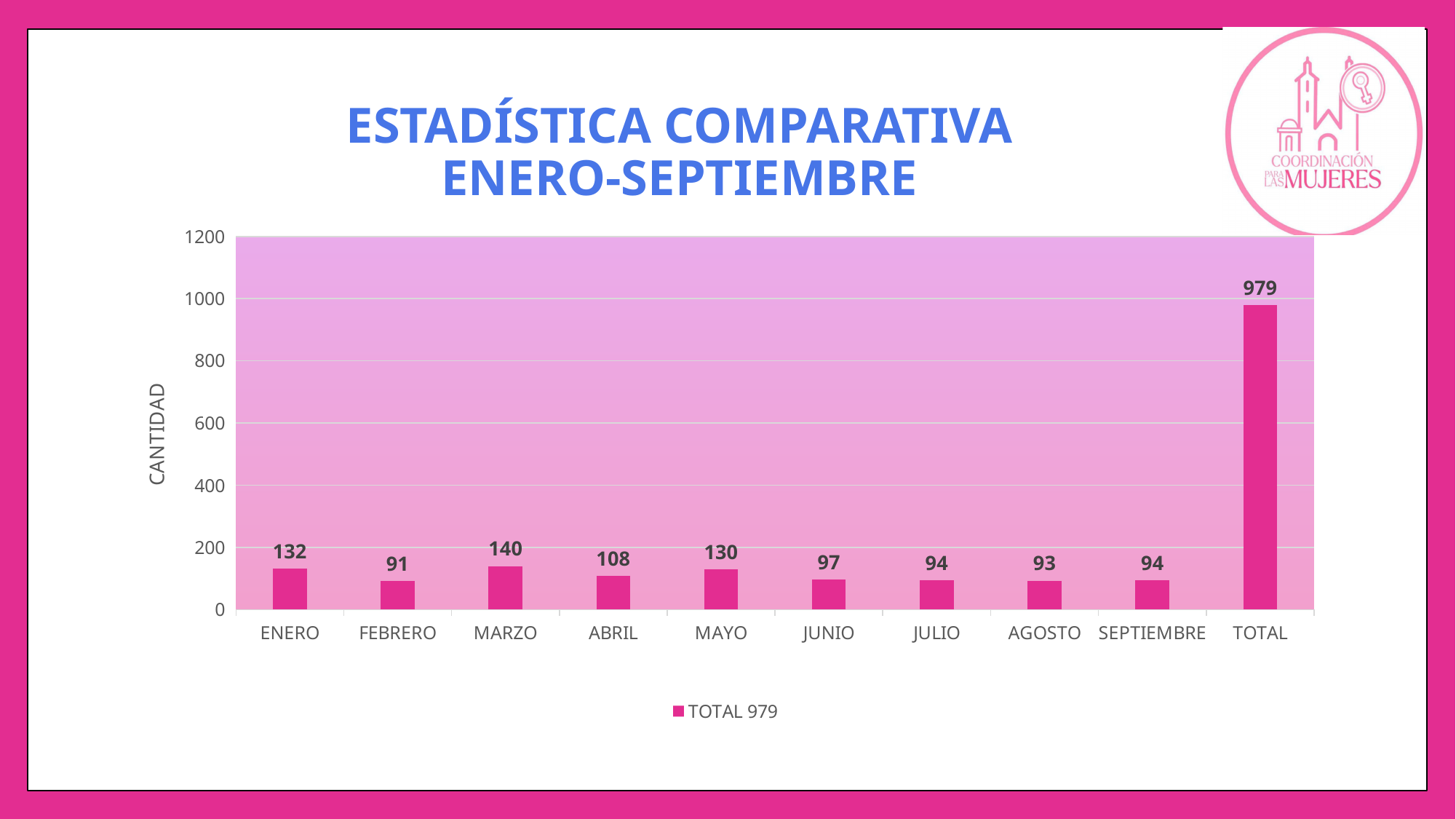
Is the value for TOTAL greater or less than 800? greater Which is larger, the value for ABRIL or the value for MAYO? MAYO What is the value for FEBRERO? 91 How many series does the legend list? 1 What kind of chart is shown on the slide? bar chart What is the difference between the values for ENERO and FEBRERO? 41 Among the monthly bars (excluding TOTAL), which month has the lowest value? FEBRERO What is the value for MARZO? 140 What is the value shown for the TOTAL bar? 979 Among the monthly bars (excluding TOTAL), which month has the highest value? MARZO How many bars are plotted in the chart? 10 What is the label on the vertical axis? CANTIDAD